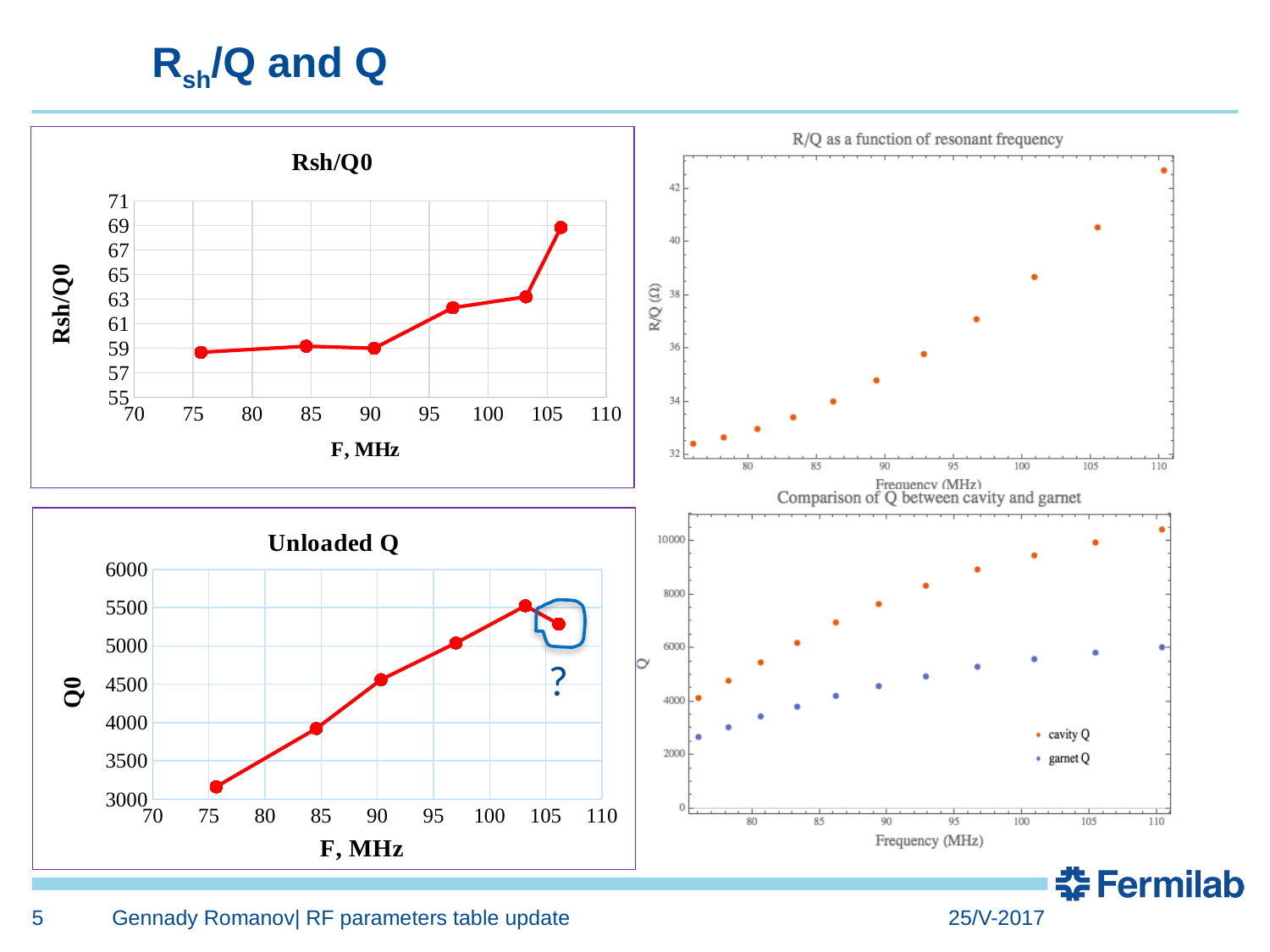
In the 'Comparison of Q between cavity and garnet' chart, which series has the higher value at 110 MHz, cavity Q or garnet Q? cavity Q In the Unloaded Q chart, is the value at about 103 MHz greater or less than 5000? greater In the Rsh/Q0 chart, do the values generally rise or fall as frequency increases? rise In the 'R/Q as a function of resonant frequency' chart, is the value at 110 MHz greater or less than 42? greater In the Unloaded Q chart, which is larger: the value at about 103 MHz or the value at about 106 MHz? about 103 MHz In the Unloaded Q chart, how many data points are plotted? 6 In the Unloaded Q chart, is the value at about 75 MHz greater or less than 3500? less In the Rsh/Q0 chart, how many data points are plotted? 6 What kind of chart is the Rsh/Q0 chart? line chart In the 'Comparison of Q between cavity and garnet' chart, how many series does the legend list? 2